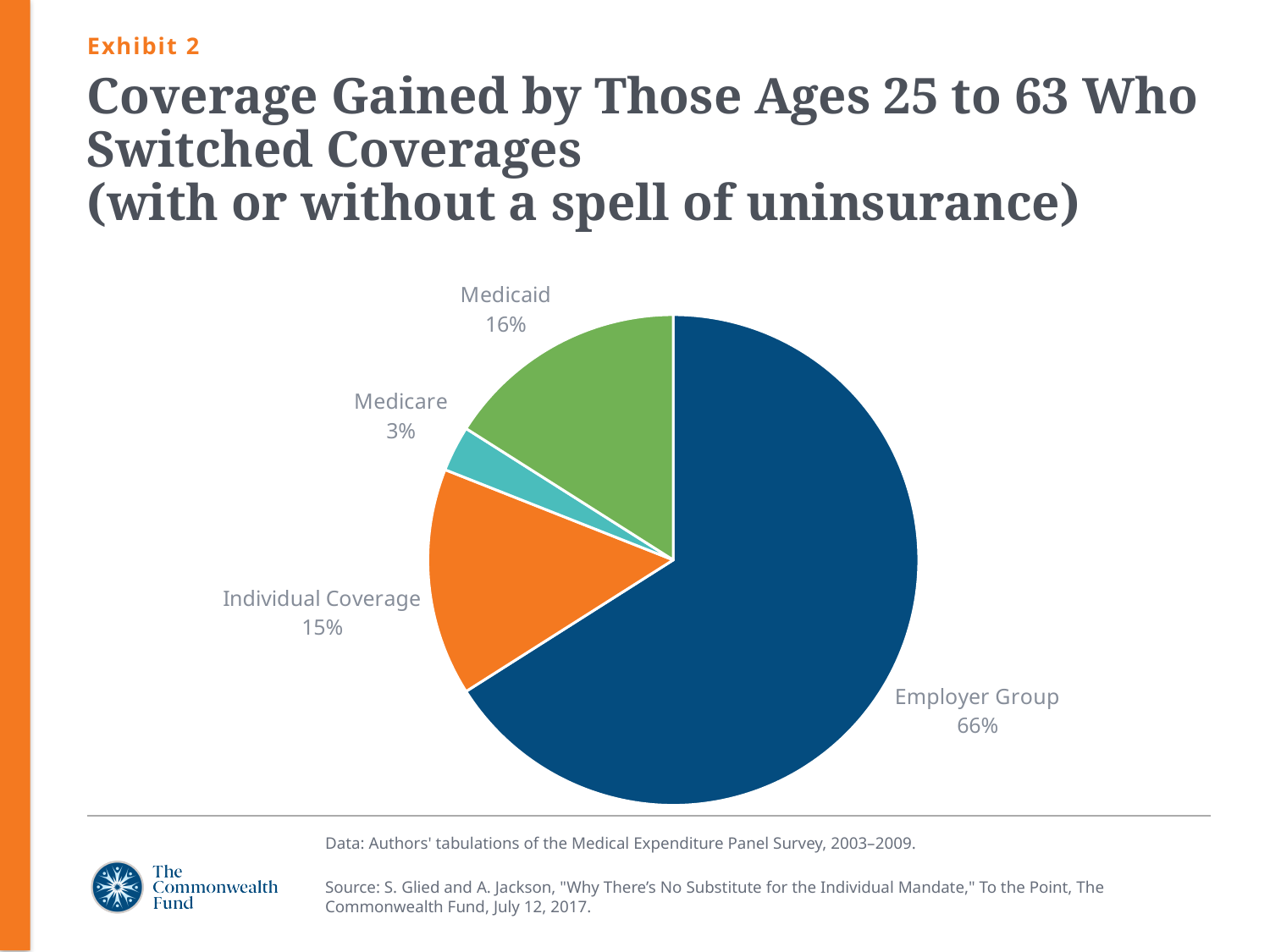
What is the value shown for Medicaid? 16% What is the difference between the Employer Group share and the Medicaid share? 50 percentage points What share of the pie does Employer Group represent? 66% How many categories are shown in the pie chart? 4 Which is larger, the Medicaid share or the Individual Coverage share? Medicaid Which category has the smallest slice of the pie? Medicare What is the value shown for Individual Coverage? 15% Which category has the largest slice of the pie? Employer Group What colour is the Employer Group slice? Dark blue What is the value shown for Medicare? 3% What is the difference between the Individual Coverage share and the Medicare share? 12 percentage points What kind of chart is shown on the slide? Pie chart